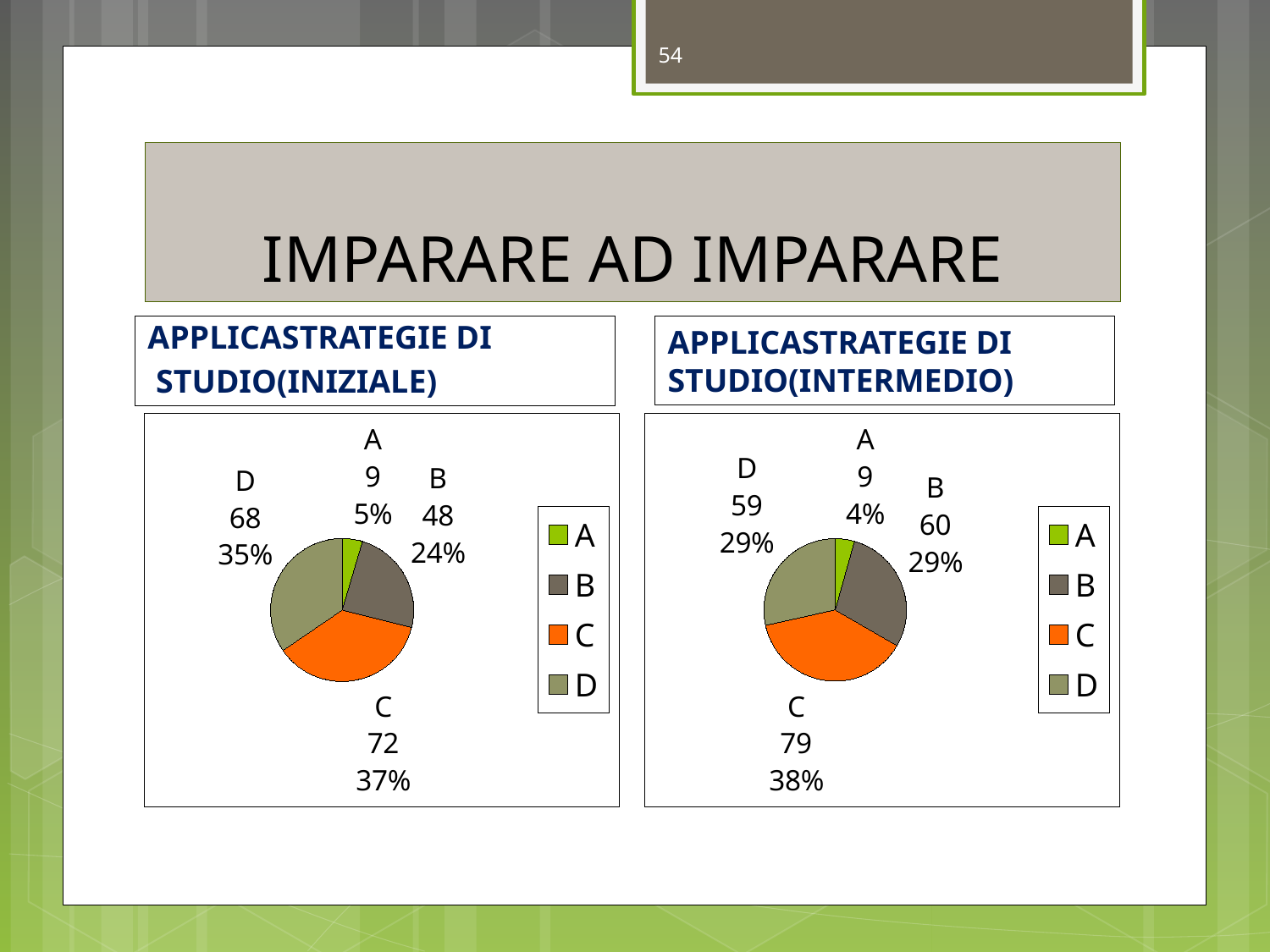
In the APPLICASTRATEGIE DI STUDIO(INTERMEDIO) chart, what is the difference between the values for C and B? 19 In the APPLICASTRATEGIE DI STUDIO(INTERMEDIO) chart, which category has the smallest slice? A In the APPLICASTRATEGIE DI STUDIO(INTERMEDIO) chart, which colour represents category C in the legend? Orange How many categories does the APPLICASTRATEGIE DI STUDIO(INTERMEDIO) chart show? 4 In the APPLICASTRATEGIE DI STUDIO(INIZIALE) chart, what percentage is shown for category B? 24% In the APPLICASTRATEGIE DI STUDIO(INIZIALE) chart, which is larger, the value for D or the value for B? D In the APPLICASTRATEGIE DI STUDIO(INTERMEDIO) chart, what percentage is shown for category A? 4% In the APPLICASTRATEGIE DI STUDIO(INTERMEDIO) chart, what value is shown for category D? 59 In the APPLICASTRATEGIE DI STUDIO(INIZIALE) chart, what value is shown for category C? 72 In the APPLICASTRATEGIE DI STUDIO(INIZIALE) chart, what is the difference between the values for D and B? 20 What type of chart is the APPLICASTRATEGIE DI STUDIO(INIZIALE) chart? Pie chart In the APPLICASTRATEGIE DI STUDIO(INIZIALE) chart, which category has the largest slice? C